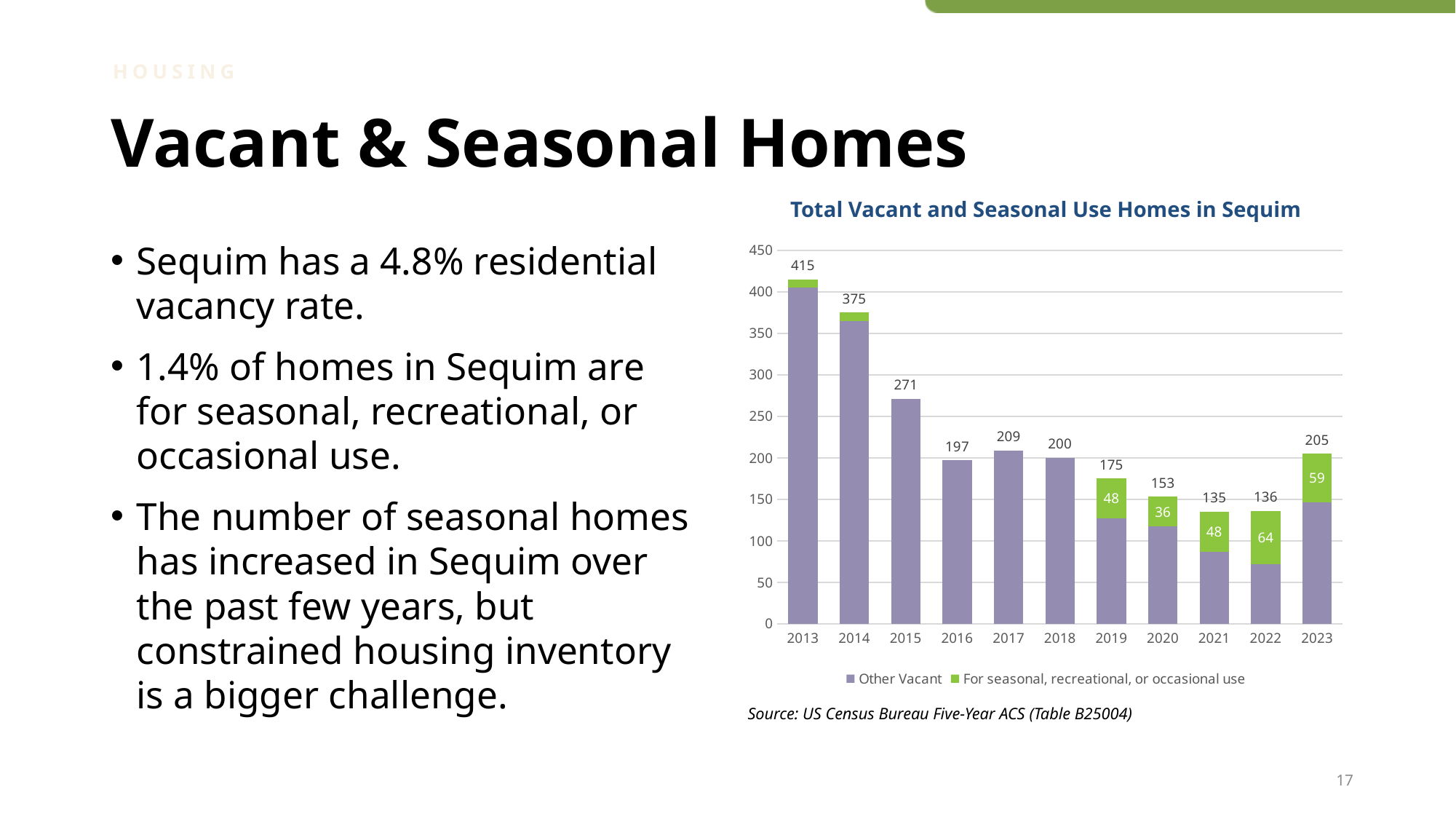
What is the total number of vacant and seasonal use homes in Sequim in 2013? 415 What is the value labeled for seasonal, recreational, or occasional use in 2020? 36 How many series does the chart legend list? 2 Which year has a larger total, 2017 or 2018? 2017 Which year has the highest total of vacant and seasonal use homes? 2013 How many homes were for seasonal, recreational, or occasional use in 2022? 64 How many years are shown on the x axis of the chart? 11 Is the Other Vacant value for 2022 greater or less than 100? less What kind of chart is shown on the slide? Stacked bar chart What is the difference between the total for 2013 and the total for 2014? 40 Do the total values rise or fall from 2013 to 2021? Fall Which year has the lowest total of vacant and seasonal use homes? 2021